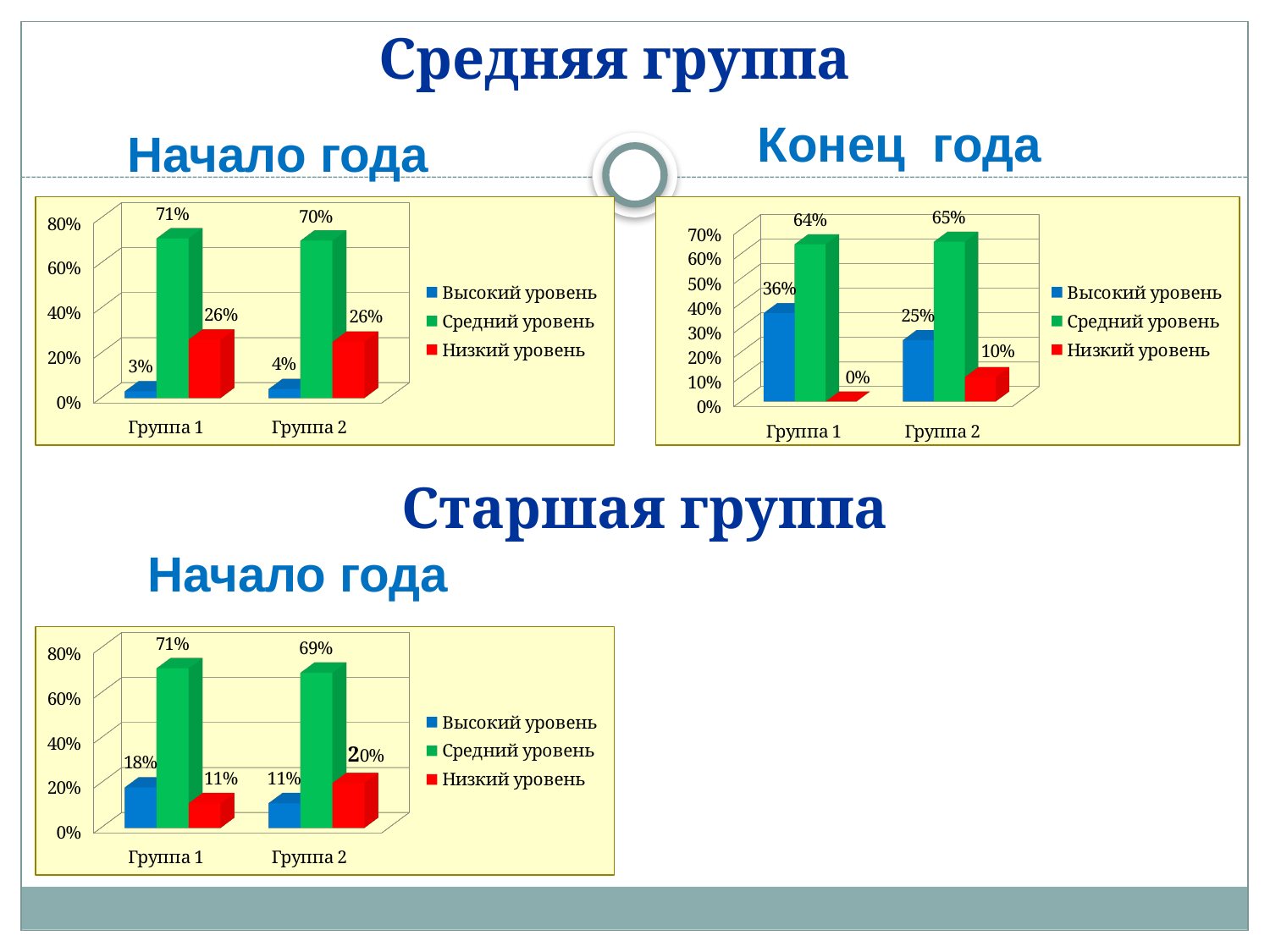
How many categories are shown on the x axis of the bottom chart (Старшая группа, Начало года)? 2 In the bottom chart (Старшая группа, Начало года), what is the value of Низкий уровень for Группа 1? 11% How many series does the legend of the top-left chart (Средняя группа, Начало года) list? 3 In the top-right chart (Средняя группа, Конец года), what is the value of Низкий уровень for Группа 2? 10% In the top-right chart (Средняя группа, Конец года), what is the value of Высокий уровень for Группа 1? 36% In the bottom chart (Старшая группа, Начало года), which is larger: Высокий уровень for Группа 1 or Высокий уровень for Группа 2? Группа 1 In the top-right chart (Средняя группа, Конец года), which series has the lowest value for Группа 1? Низкий уровень What kind of chart is the top-right chart (Средняя группа, Конец года)? Bar chart In the top-left chart (Средняя группа, Начало года), what is the value of Высокий уровень for Группа 2? 4% In the bottom chart (Старшая группа, Начало года), which series has the highest value for Группа 2? Средний уровень In the top-right chart (Средняя группа, Конец года), what is the difference between Высокий уровень for Группа 1 and Группа 2? 11% In the top-left chart (Средняя группа, Начало года), what is the value of Средний уровень for Группа 1? 71%